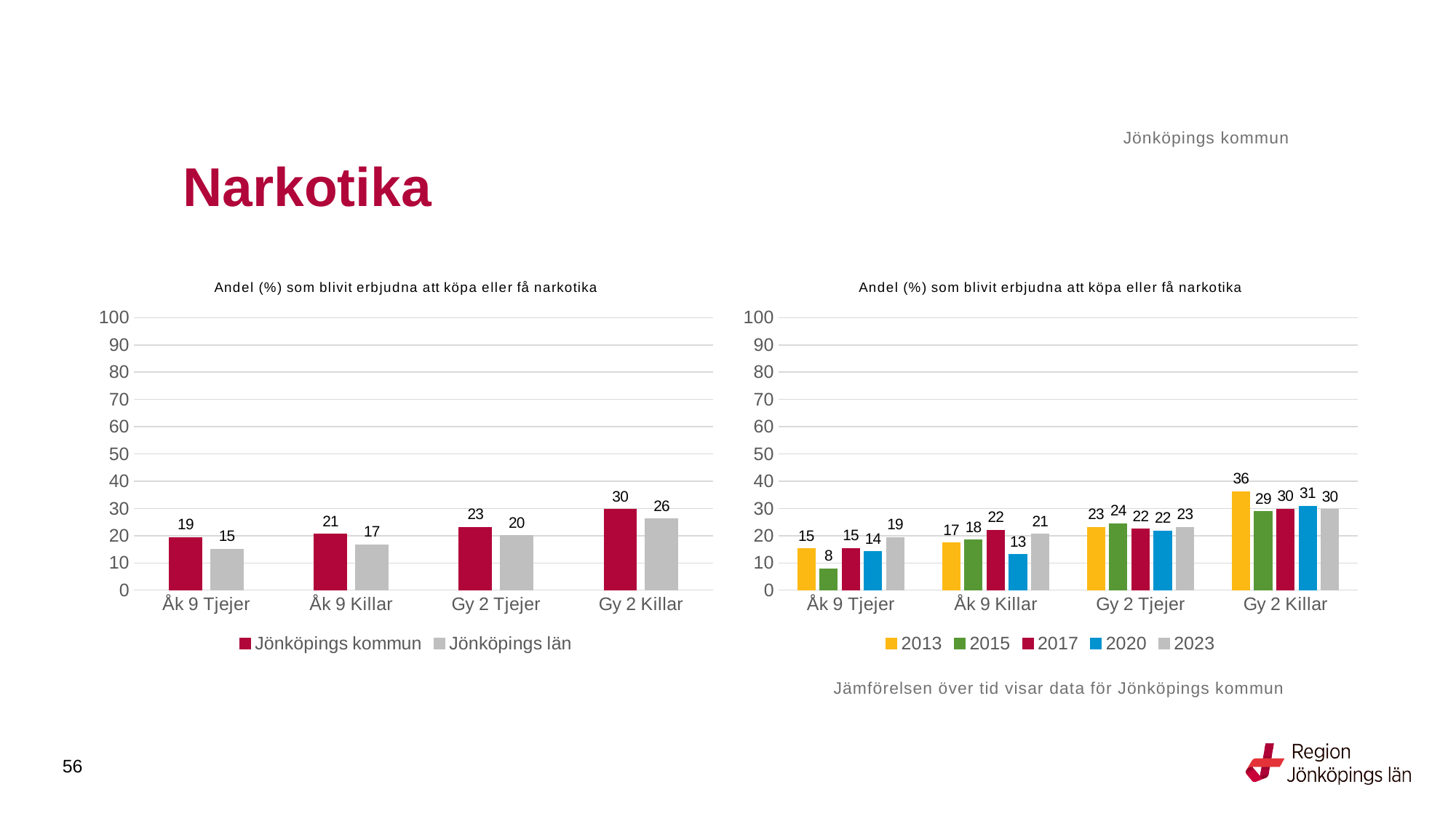
In the right chart, which is larger for Åk 9 Killar: the value for 2017 or the value for 2020? 2017 In the left chart, what is the value for Jönköpings län for Åk 9 Tjejer? 15 In the right chart, which year has the lowest value for Åk 9 Tjejer? 2015 In the left chart, how many series does the legend list? 2 In the left chart, what is the difference between Jönköpings kommun and Jönköpings län for Gy 2 Killar? 4 In the right chart, how many series does the legend list? 5 In the right chart, what is the value for 2013 for Gy 2 Killar? 36 In the right chart, how many categories are shown on the x axis? 4 In the right chart, what is the value for 2020 for Åk 9 Killar? 13 In the left chart, what is the value for Jönköpings kommun for Gy 2 Killar? 30 In the left chart, which category has the highest value for Jönköpings kommun? Gy 2 Killar What kind of chart is the left chart? Bar chart